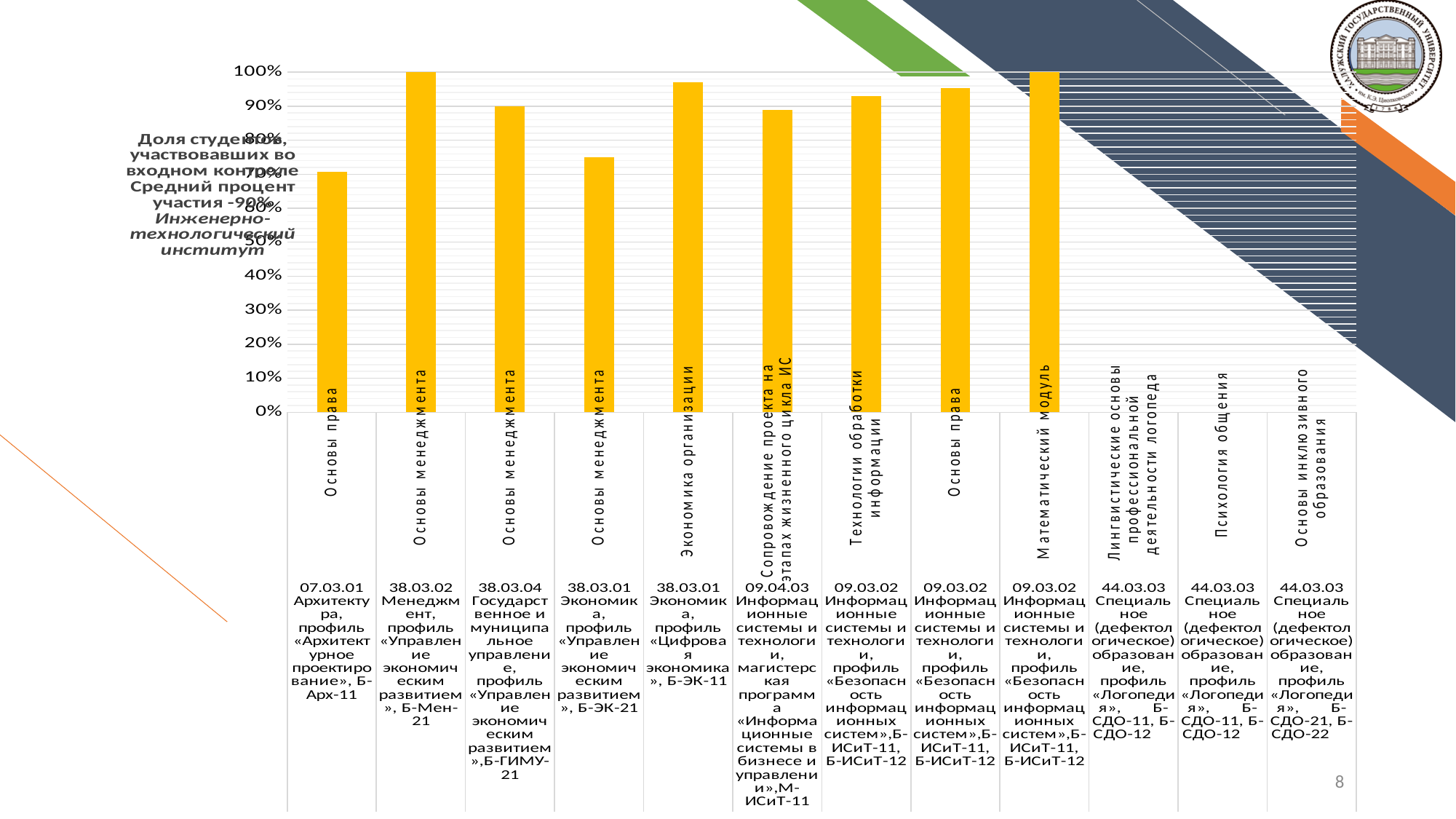
What is the value for Математический модуль in the 09.03.02 programme (Б-ИСиТ-11, Б-ИСиТ-12)? 100% Is the value for Основы права in the 07.03.01 Архитектура programme (Б-Арх-11) greater or less than 80%? less According to the chart title, what is the average participation percentage (средний процент участия)? 90% What is the value for Основы менеджмента in the 38.03.02 Менеджмент programme (Б-Мен-21)? 100% Is the value for Экономика организации (Б-ЭК-11) greater or less than 90%? greater Which is larger: the value for Основы менеджмента in Б-Мен-21 or the value for Основы менеджмента in Б-ЭК-21? Основы менеджмента in Б-Мен-21 Which is larger: the value for Экономика организации (Б-ЭК-11) or the value for Основы права in Б-Арх-11? Экономика организации (Б-ЭК-11) What is the value for Основы менеджмента in the 38.03.04 programme (Б-ГИМУ-21)? 90% How many categories (courses) are listed along the x axis of the chart? 12 Is the value for Основы менеджмента in the 38.03.01 Экономика programme (Б-ЭК-21) greater or less than 80%? less What kind of chart is shown on the slide? bar chart